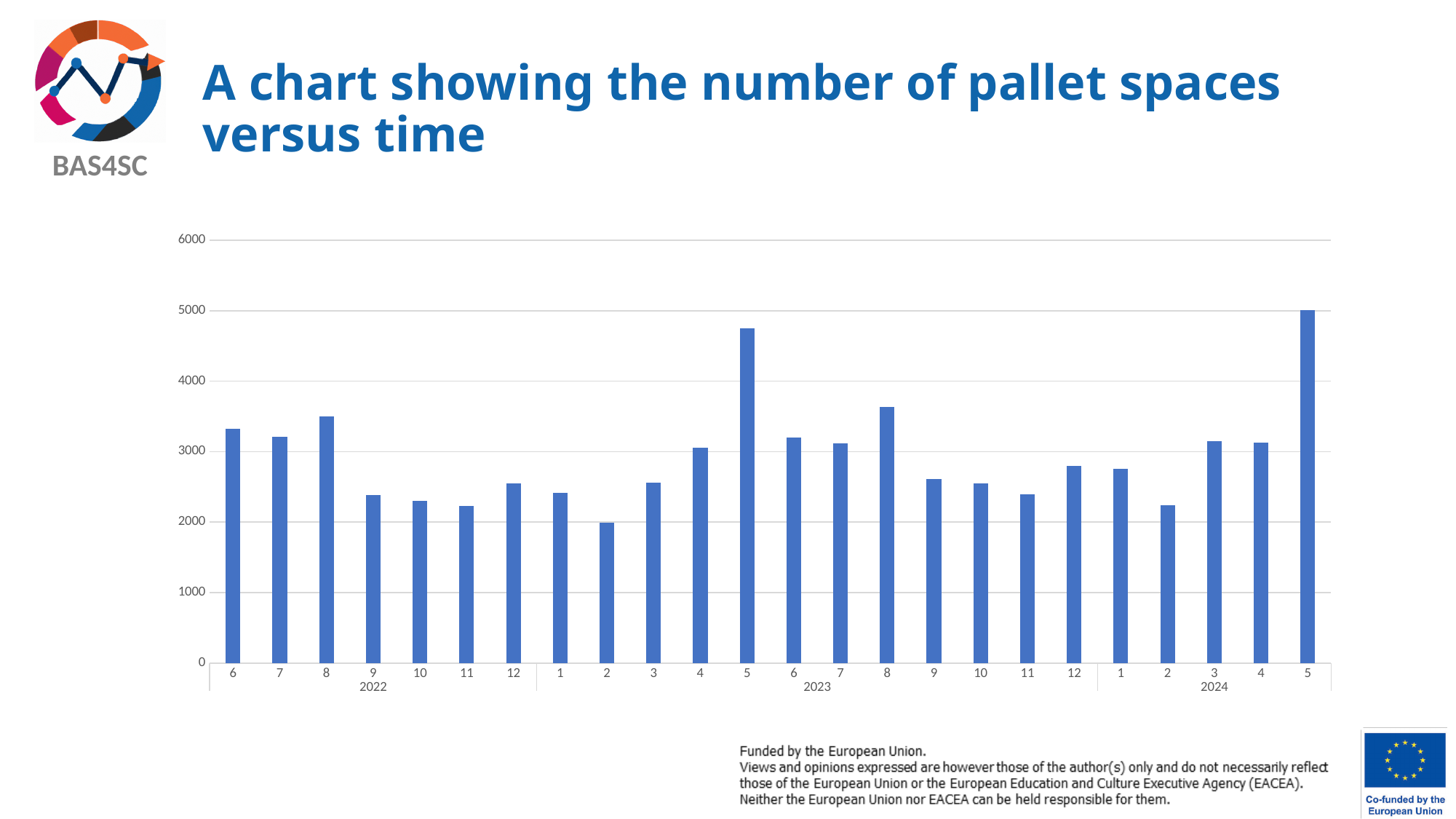
Which is larger, the value for month 8 of 2022 or month 9 of 2022? Month 8 of 2022 Which month has the highest number of pallet spaces? Month 5 of 2024 Which is larger, the value for month 5 of 2023 or month 8 of 2023? Month 5 of 2023 Which month has the lowest number of pallet spaces? Month 2 of 2023 What is the title of the slide? A chart showing the number of pallet spaces versus time Is the value for month 10 of 2022 greater or less than 3000? less How many bars (months) are plotted in the chart? 24 Is the value for month 5 of 2023 greater or less than 4000? greater Do the values rise or fall from month 9 to month 11 of 2022? fall Is the value for month 8 of 2023 greater or less than 3000? greater What kind of chart is shown on the slide? bar chart